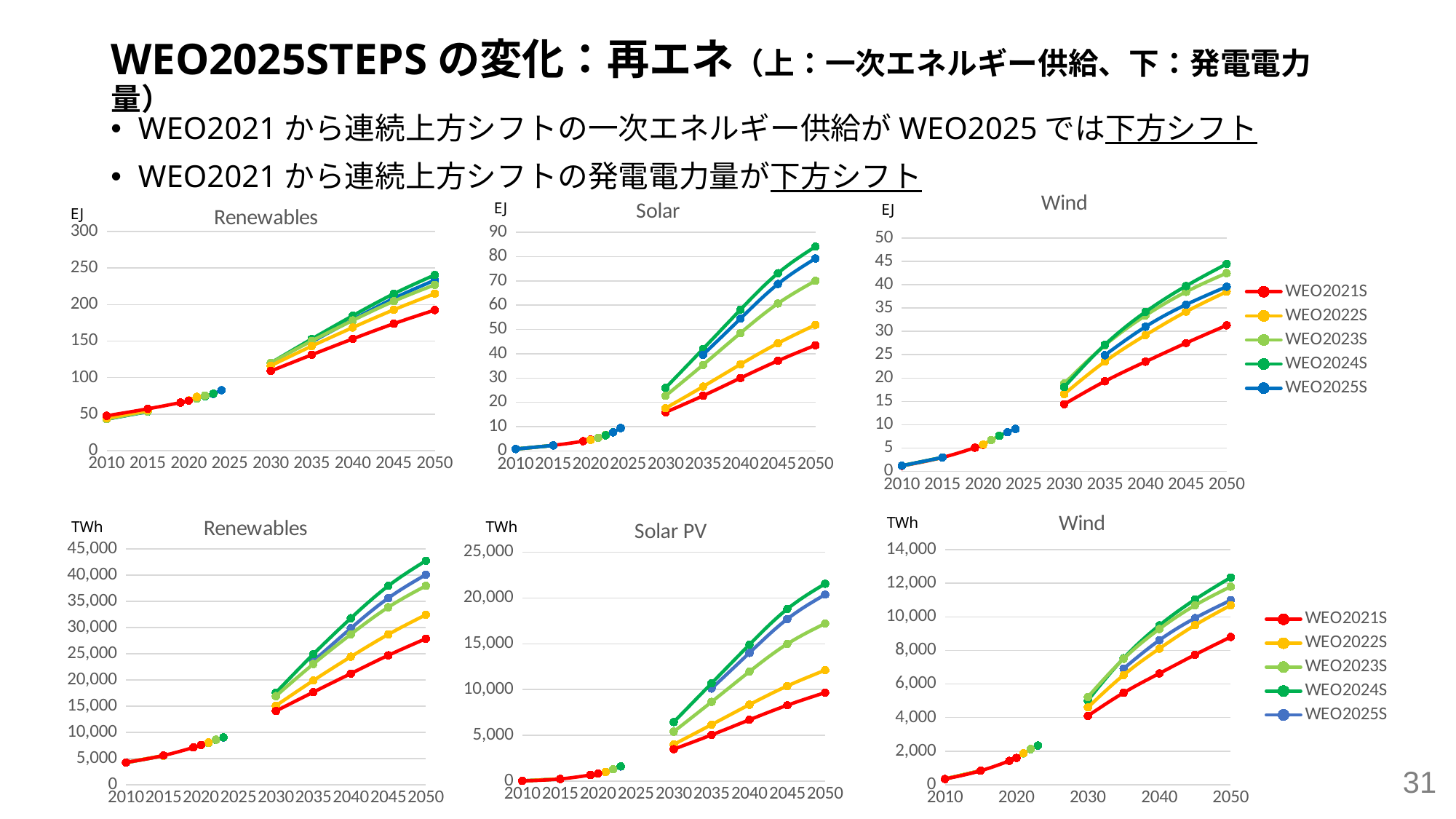
In the top-middle "Solar" chart, is the WEO2024S value at 2050 greater or less than 80? greater In the top-middle "Solar" chart, which series has the lowest value at 2050? WEO2021S In the top-middle "Solar" chart, which series has the highest value at 2050? WEO2024S In the bottom-middle "Solar PV" chart, do the WEO2024S values rise or fall from 2030 to 2050? rise In the bottom-right "Wind" chart, which series has the lowest value at 2050? WEO2021S How many series does the legend list for the top-right "Wind" chart? 5 In the bottom-left "Renewables" chart, which series has the highest value at 2050? WEO2024S What kind of chart is the top-left "Renewables" chart? line chart In the top-left "Renewables" chart, is the WEO2021S value at 2050 greater or less than 200? less In the top-middle "Solar" chart, which is larger at 2050: WEO2025S or WEO2022S? WEO2025S In the top-right "Wind" chart, is the WEO2021S value at 2050 greater or less than 35? less